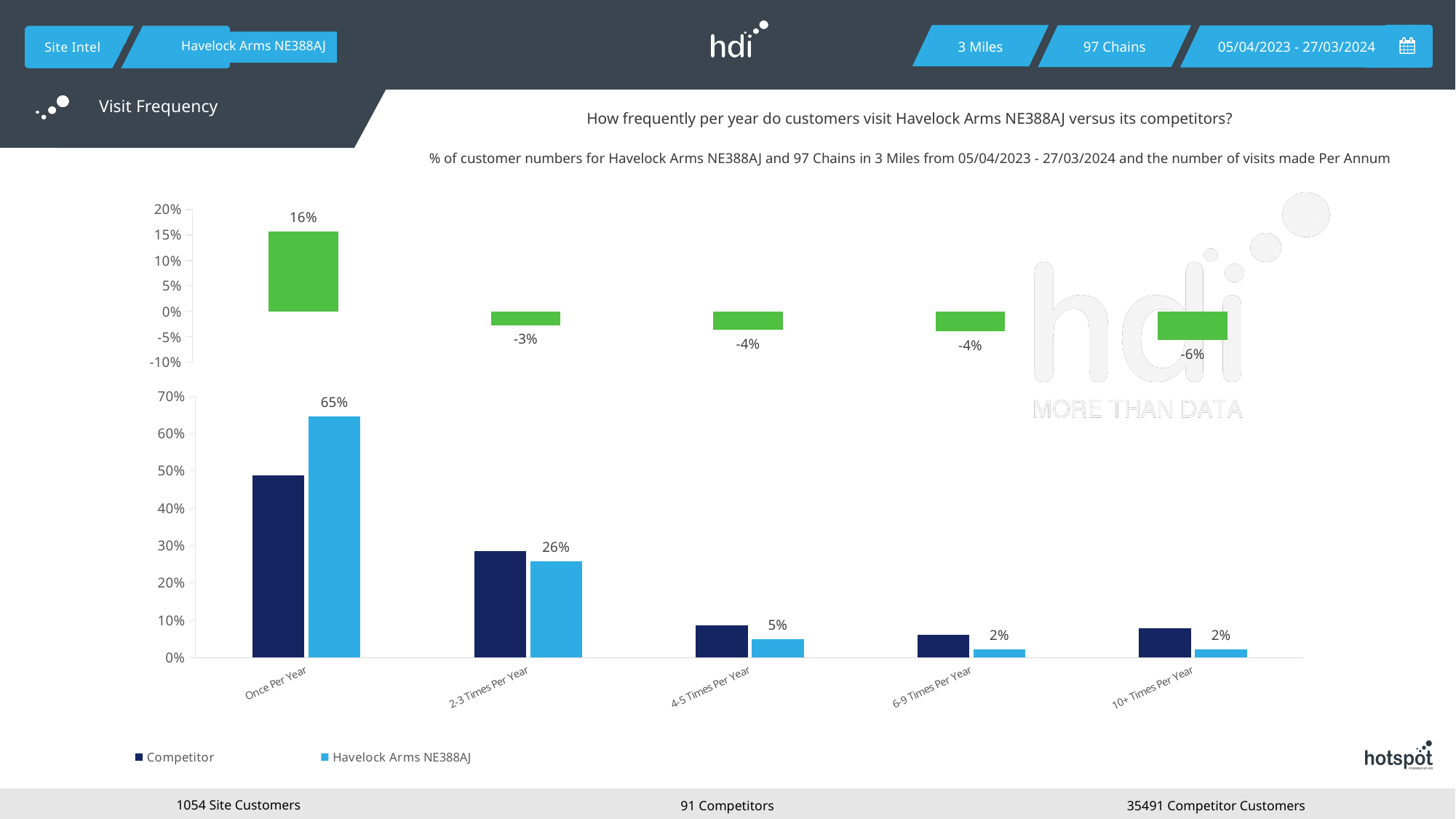
In the bottom chart, what is the value for Havelock Arms NE388AJ for Once Per Year? 65% In the bottom chart, what is the value for Havelock Arms NE388AJ for 2-3 Times Per Year? 26% In the bottom chart, is the Competitor value for Once Per Year greater or less than 40%? greater In the top chart, which category has the lowest value? 10+ Times Per Year How many series does the legend of the bottom chart list? 2 In the bottom chart, what is the value for Havelock Arms NE388AJ for 4-5 Times Per Year? 5% In the top chart, what is the value for Once Per Year? 16% In the bottom chart, what is the difference between the Havelock Arms NE388AJ values for Once Per Year and 2-3 Times Per Year? 39% In the bottom chart, which category has the highest value for Havelock Arms NE388AJ? Once Per Year How many categories are shown on the x axis of the bottom chart? 5 In the bottom chart, which is larger for Once Per Year: Competitor or Havelock Arms NE388AJ? Havelock Arms NE388AJ In the top chart, what is the value for 10+ Times Per Year? -6%